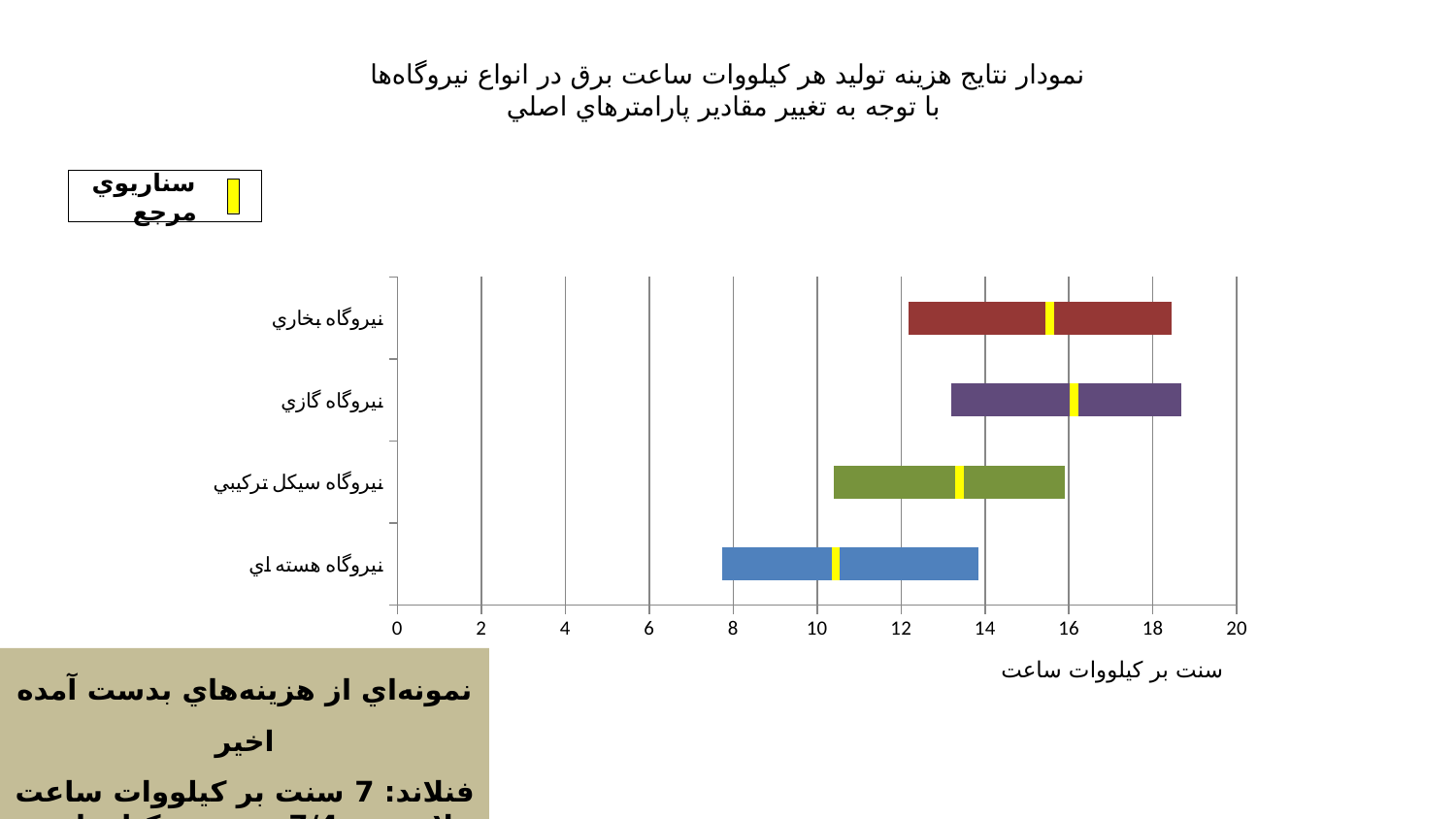
Which has a larger reference scenario value, نيروگاه سيكل تركيبي or نيروگاه هسته اي? نيروگاه سيكل تركيبي Which power plant has the lowest lower end of its cost range? نيروگاه هسته اي Is the lower end of the cost range for نيروگاه سيكل تركيبي greater or less than 12? less How many power plant types (categories) are plotted on the chart? 4 What is the label of the horizontal axis? سنت بر کیلووات ساعت Is the upper end of the cost range for نيروگاه گازي greater or less than 18? greater Is the reference scenario value for نيروگاه هسته اي greater or less than 12? less Which power plant has the lowest reference scenario (yellow marker) value? نيروگاه هسته اي What kind of chart is shown on the slide? bar chart What does the yellow marker in the legend represent? سناريوي مرجع